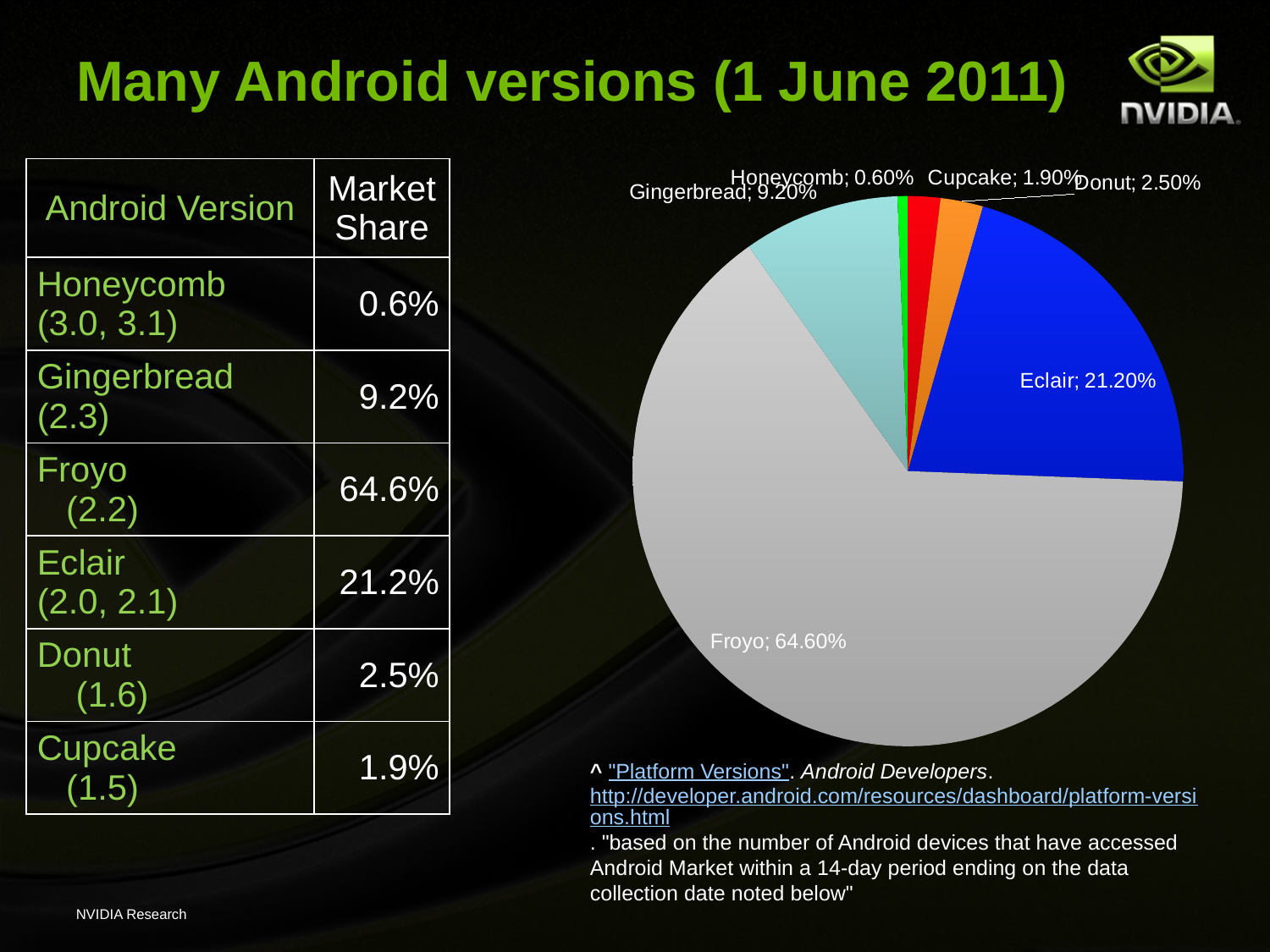
How many slices does the pie chart have? 6 Which Android version has the smallest slice in the pie chart? Honeycomb What is the market share shown for Donut in the pie chart? 2.50% What is the market share shown for Honeycomb in the pie chart? 0.60% Which Android version has the largest slice in the pie chart? Froyo Which has a larger share in the pie chart, Donut or Cupcake? Donut What is the market share shown for Eclair in the pie chart? 21.20% What is the market share shown for Gingerbread in the pie chart? 9.20% What is the difference between the Froyo and Eclair shares in the pie chart? 43.40% What is the market share shown for Froyo in the pie chart? 64.60% What colour is the Eclair slice in the pie chart? blue What kind of chart is shown on the slide? pie chart